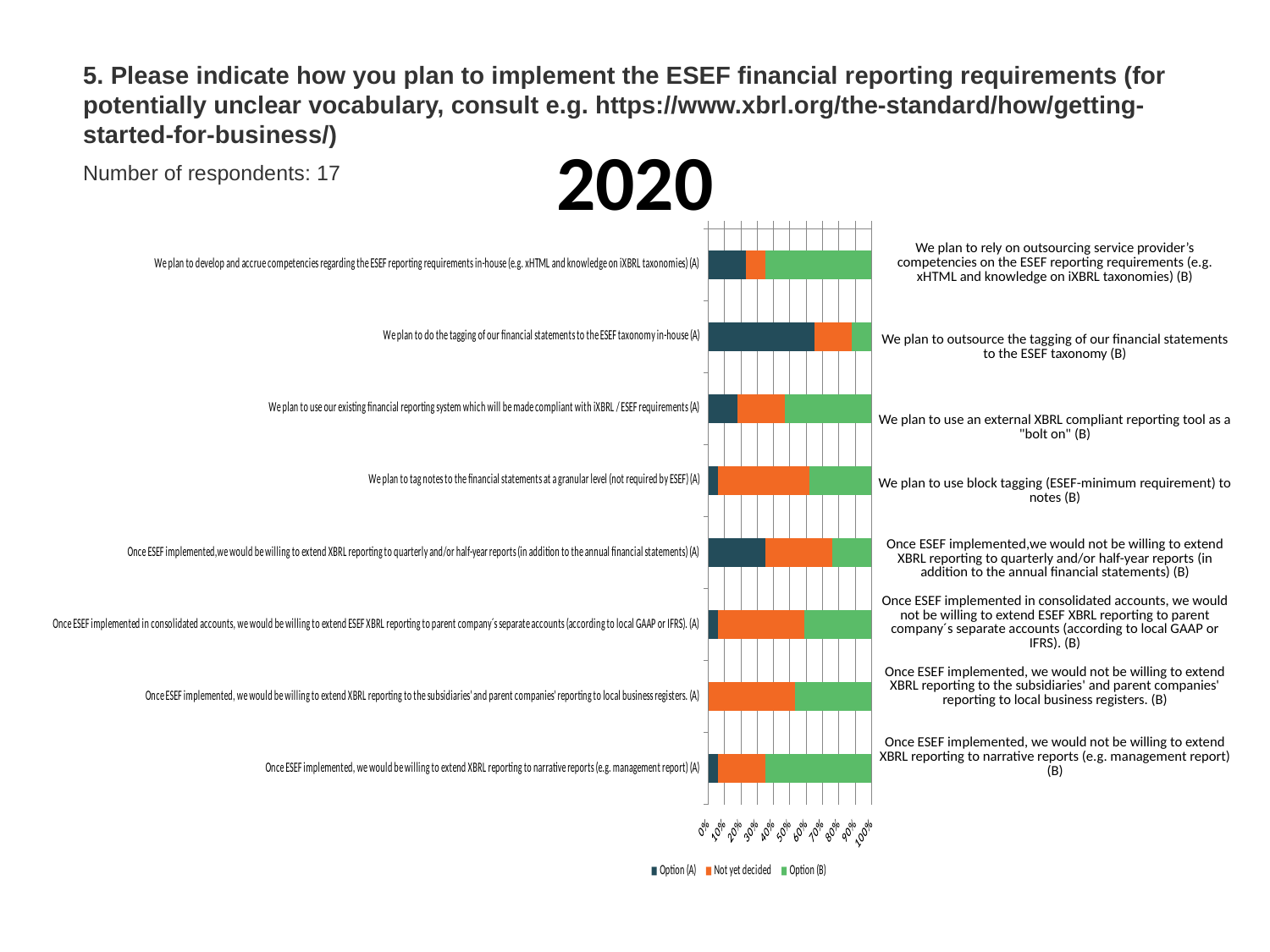
Is the Option (A) share for 'We plan to do the tagging of our financial statements to the ESEF taxonomy in-house (A)' greater or less than 50%? greater What is the title of the chart? 2020 How many statement categories (bars) are plotted in the chart? 8 Which category has the smallest Option (A) share? Once ESEF implemented, we would be willing to extend XBRL reporting to the subsidiaries' and parent companies' reporting to local business registers. (A) Which has the larger Option (A) share: 'We plan to do the tagging of our financial statements to the ESEF taxonomy in-house (A)' or 'We plan to develop and accrue competencies regarding the ESEF reporting requirements in-house (A)'? We plan to do the tagging of our financial statements to the ESEF taxonomy in-house (A) Is the Option (B) share for 'We plan to develop and accrue competencies regarding the ESEF reporting requirements in-house (A)' greater or less than 50%? greater Is the Option (B) share for 'We plan to do the tagging of our financial statements to the ESEF taxonomy in-house (A)' greater or less than 20%? less What are the three series named in the legend? Option (A), Not yet decided, Option (B) What kind of chart is shown on the slide? Stacked bar chart Which category has the largest Option (A) share? We plan to do the tagging of our financial statements to the ESEF taxonomy in-house (A) How many series does the chart legend list? 3